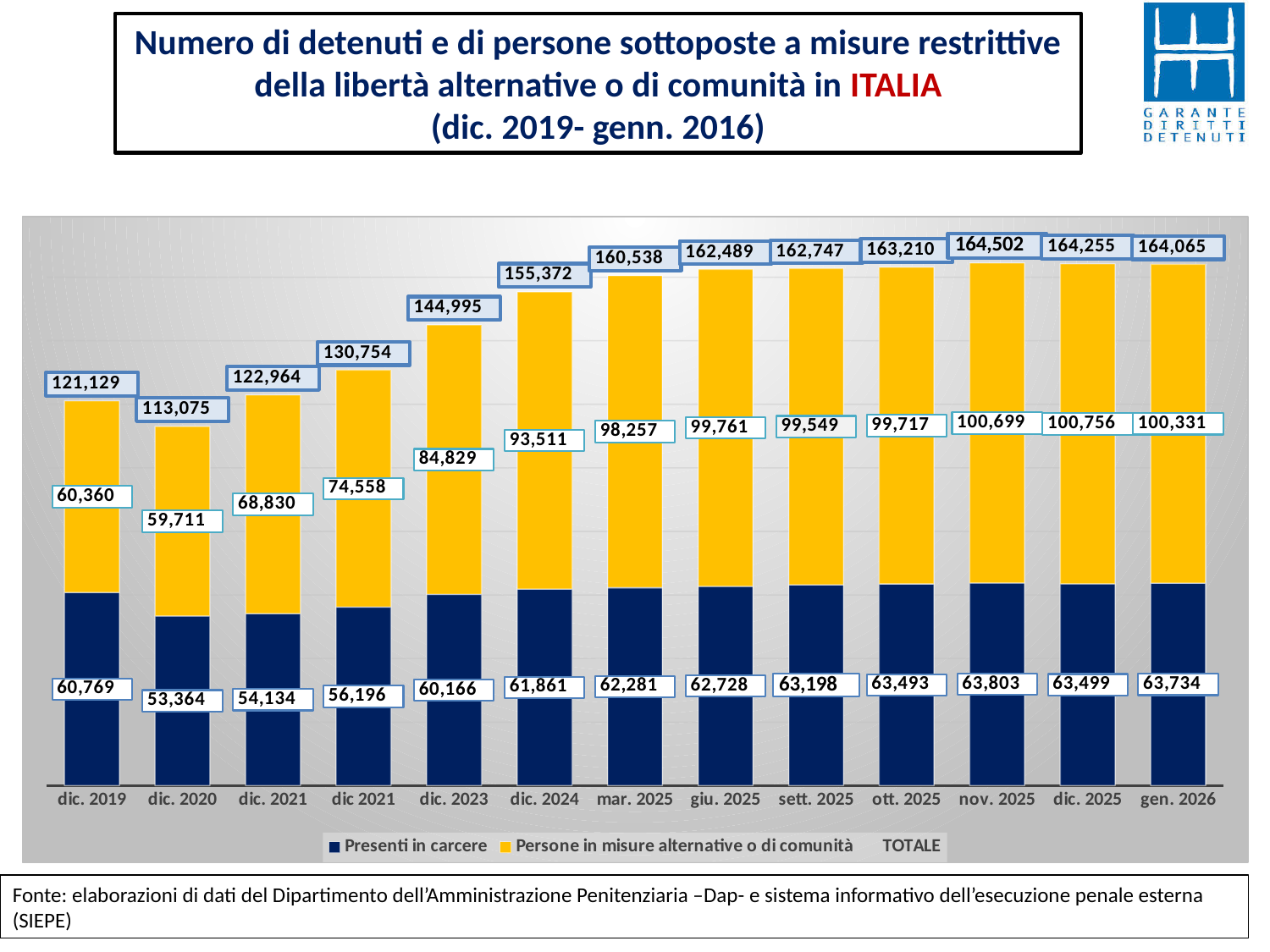
How many entries does the legend list? 3 What is the value of Presenti in carcere for dic. 2020? 53,364 Does the TOTALE value rise or fall from dic. 2020 to nov. 2025? Rise What is the difference between the TOTALE for gen. 2026 and the TOTALE for dic. 2019? 42,936 Which period has the highest TOTALE value? nov. 2025 Which period has the lowest TOTALE value? dic. 2020 Which is larger for dic. 2024: Presenti in carcere or Persone in misure alternative o di comunità? Persone in misure alternative o di comunità What is the TOTALE value for dic. 2019? 121,129 What kind of chart is shown on the slide? Stacked bar chart How many periods are shown on the x axis? 13 Which period has the lowest value for Presenti in carcere? dic. 2020 What is the value of Persone in misure alternative o di comunità for gen. 2026? 100,331